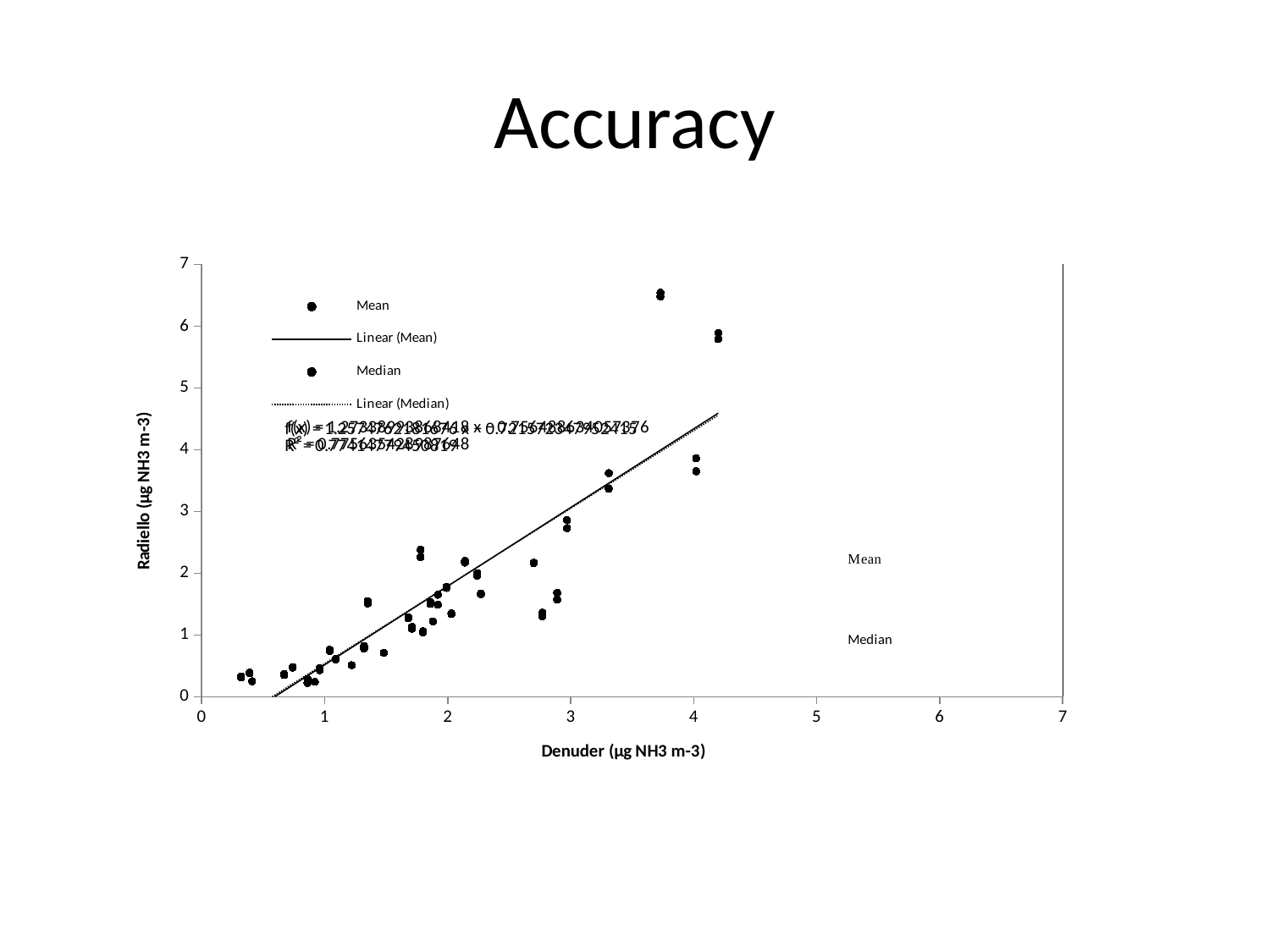
What is the maximum value shown on the y axis of the chart? 7 How many entries does the chart's legend list? 4 What is the label of the x axis of the chart? Denuder (µg NH3 m-3) What is the title of the slide containing the chart? Accuracy What is the maximum value shown on the x axis of the chart? 7 Do the Radiello values generally rise or fall as the Denuder values increase along the x axis? rise Are the Radiello values of the points plotted near Denuder = 4.2 greater or less than 5? greater Which two data series are plotted as points in the chart? Mean and Median Is the Radiello value of the highest plotted point greater or less than 6? greater What kind of chart is shown on the slide? scatter chart Are the Radiello values of the points plotted near Denuder = 4 greater or less than 4? less